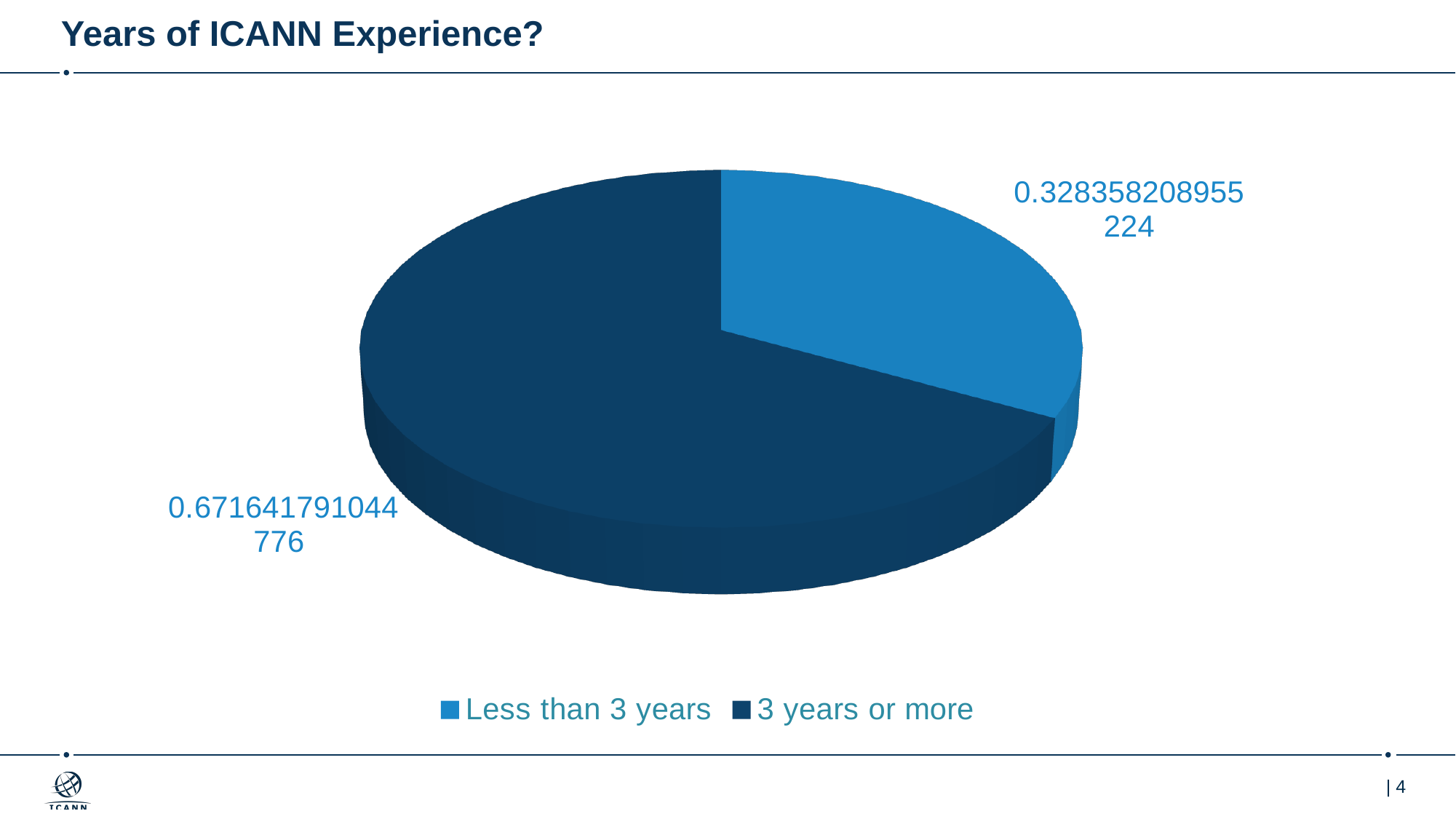
Which slice is larger: 'Less than 3 years' or '3 years or more'? 3 years or more How many entries does the legend list? 2 What kind of chart is shown on the slide? Pie chart What is the value shown for the '3 years or more' slice? 0.671641791044776 Which legend entry is shown in the lighter blue colour? Less than 3 years What is the value shown for the 'Less than 3 years' slice? 0.328358208955224 What is the title of the chart? Years of ICANN Experience? Which category has the largest slice of the pie? 3 years or more Which category has the smallest slice of the pie? Less than 3 years How many categories does the pie chart show? 2